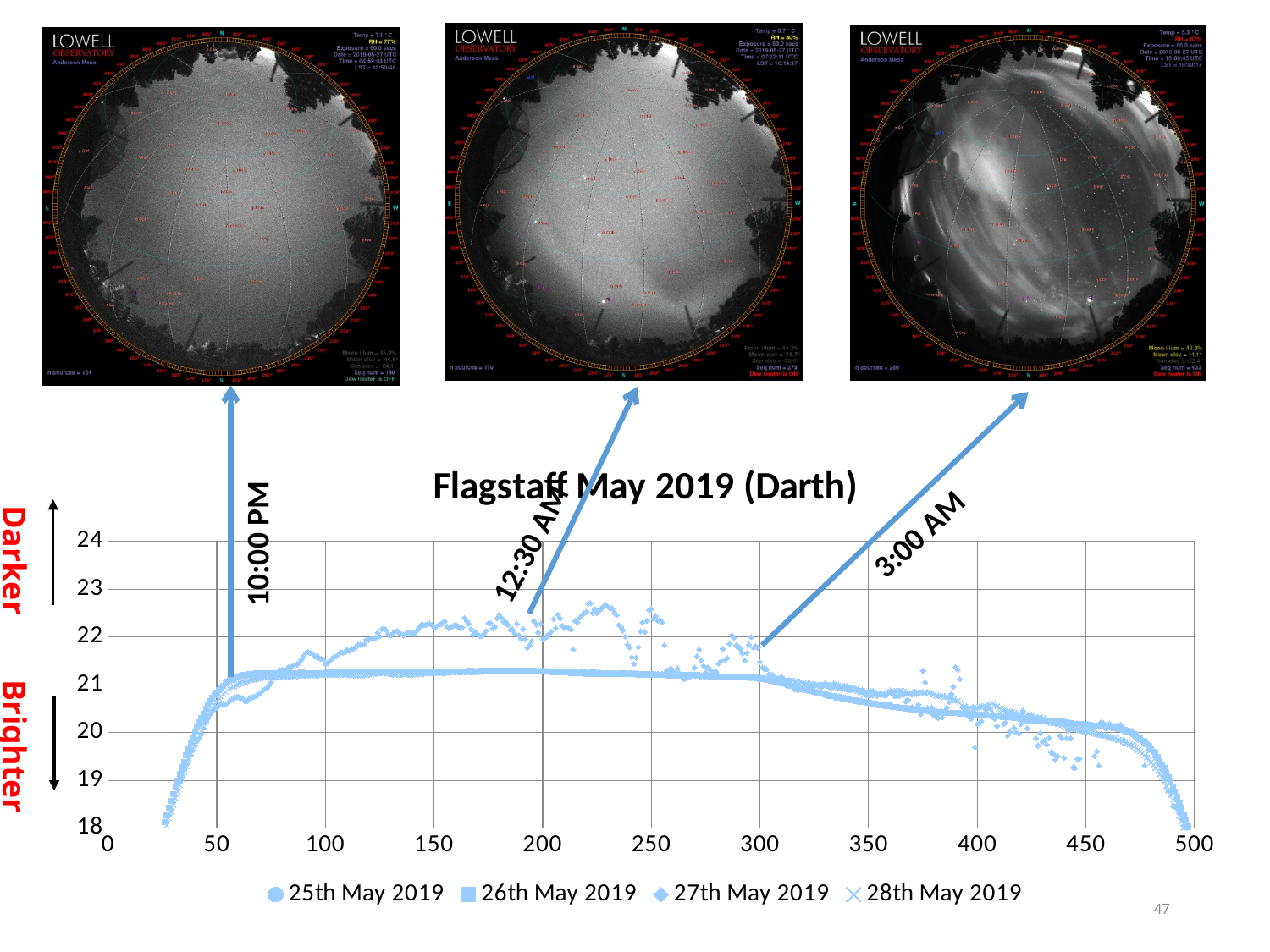
What is the highest value shown on the chart's y axis? 24 Is the value for the 26th May 2019 series at x = 200 greater or less than 20? greater Is the value for the 25th May 2019 series at x = 450 greater or less than 21? less Which dates are listed in the chart's legend? 25th May 2019, 26th May 2019, 27th May 2019, 28th May 2019 How many series does the legend of the chart list? 4 Between x = 450 and x = 500, do the plotted values rise or fall? fall What kind of chart is shown on the slide? Scatter chart Between x = 25 and x = 50, do the plotted values rise or fall? rise Is the highest value plotted on the chart greater or less than 23? less What is the title of the chart? Flagstaff May 2019 (Darth)